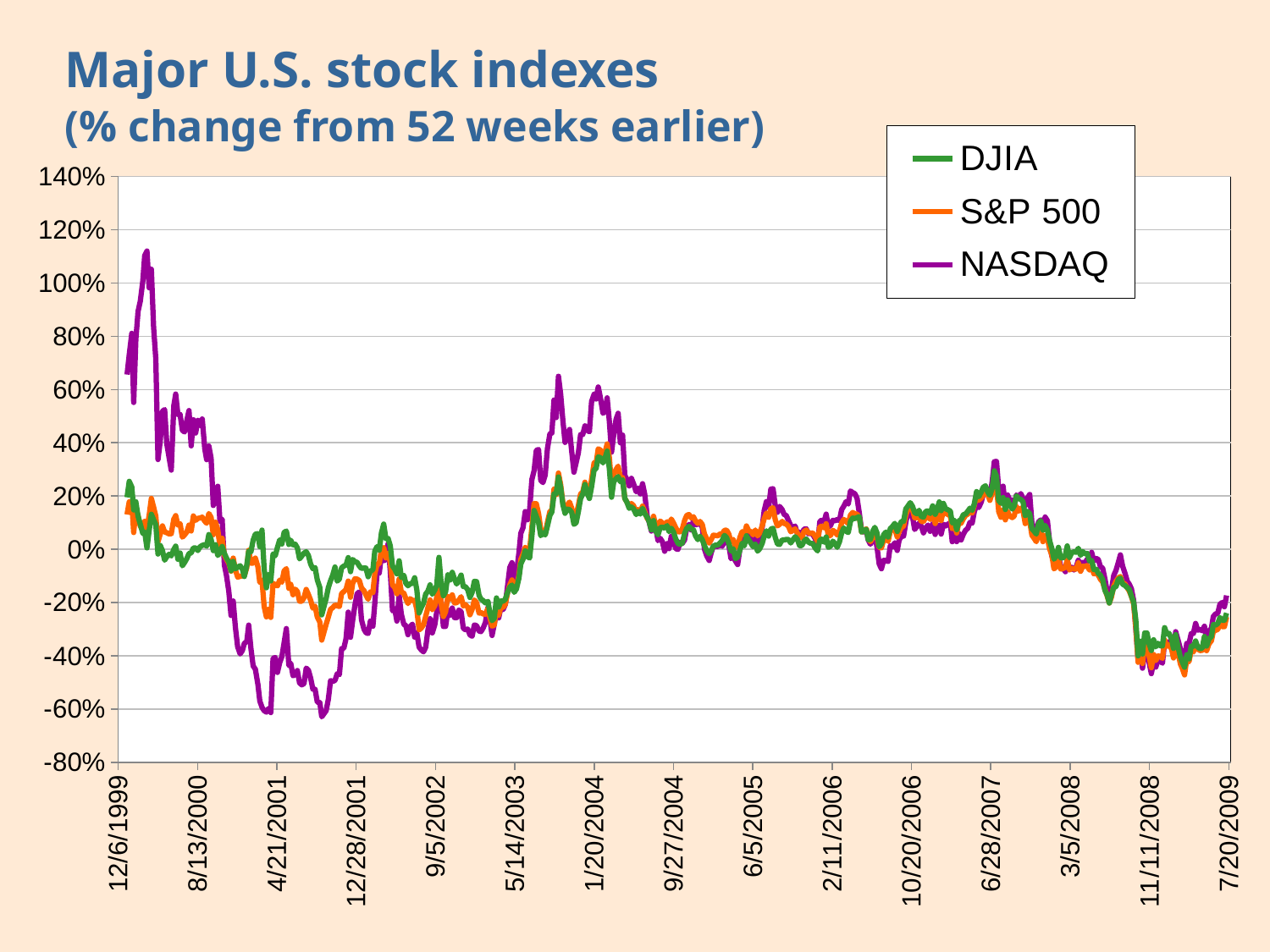
Is the lowest value for NASDAQ in 2001 greater or less than -40%? less How many date labels are shown on the x axis? 15 Do the values for all three indexes rise or fall between 6/28/2007 and 11/11/2008? fall How many series does the legend list? 3 Which series reaches the lowest value on the chart? NASDAQ Which series reaches the highest value on the chart? NASDAQ Is the peak value for NASDAQ in early 2000 greater or less than 100%? greater Is the value for DJIA around 11/11/2008 greater or less than -20%? less What is the title of the chart? Major U.S. stock indexes (% change from 52 weeks earlier) Which series is drawn in purple? NASDAQ What kind of chart is shown on the slide? line chart At 12/6/1999, which is larger, the value for NASDAQ or the value for DJIA? NASDAQ